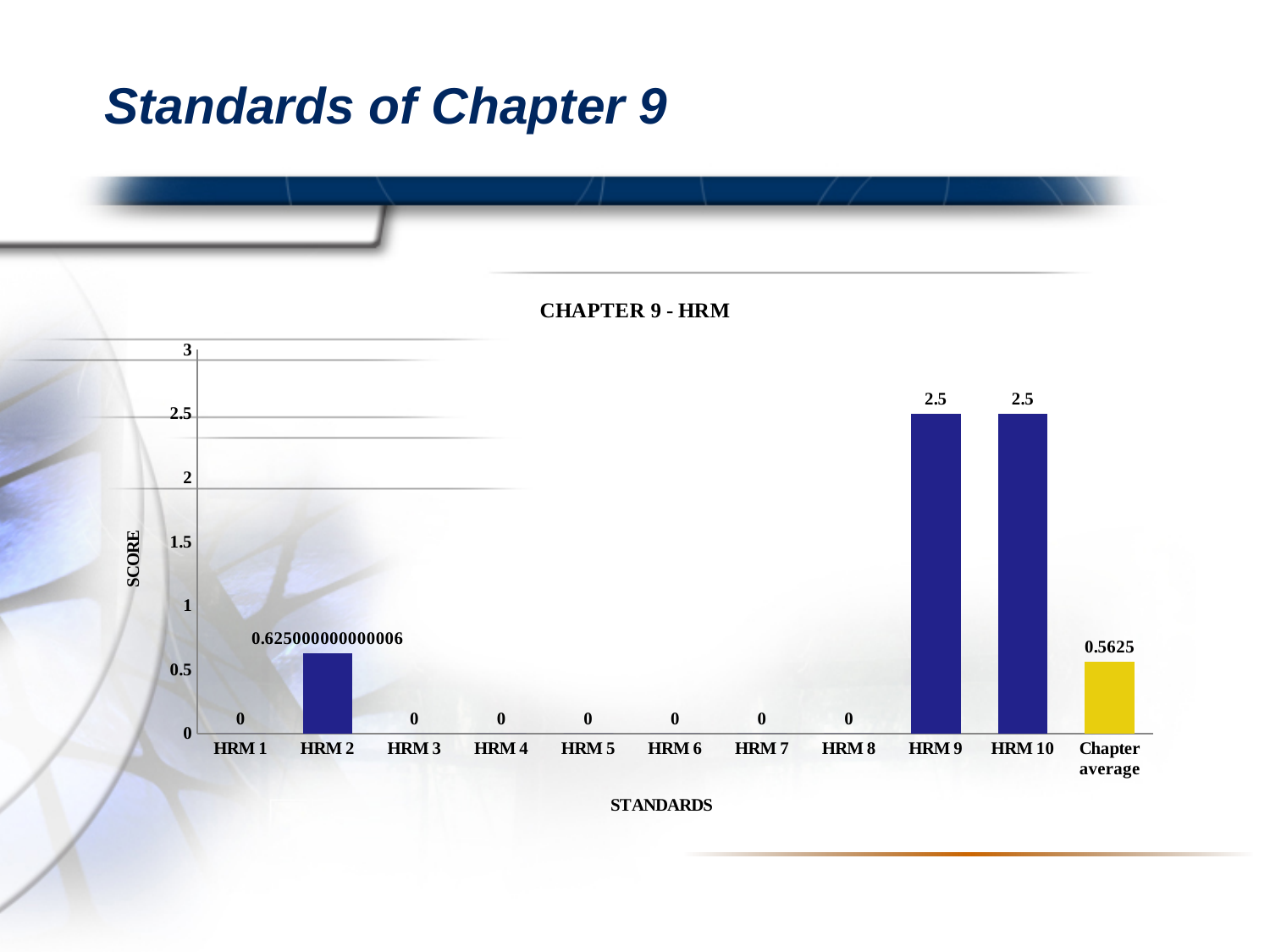
Is the score for HRM 9 greater or less than 2? greater How many categories are shown on the x axis? 11 What is the score for HRM 2? 0.625000000000006 What type of chart is shown? Bar chart What is the title of the chart? CHAPTER 9 - HRM Which standard has the lowest non-zero score? HRM 2 What is the difference between the score for HRM 10 and the Chapter average? 1.9375 What is the score for HRM 9? 2.5 Which is larger, the score for HRM 2 or the Chapter average? HRM 2 How many standards have a score of 0? 7 What is the score for HRM 5? 0 What is the value shown for Chapter average? 0.5625